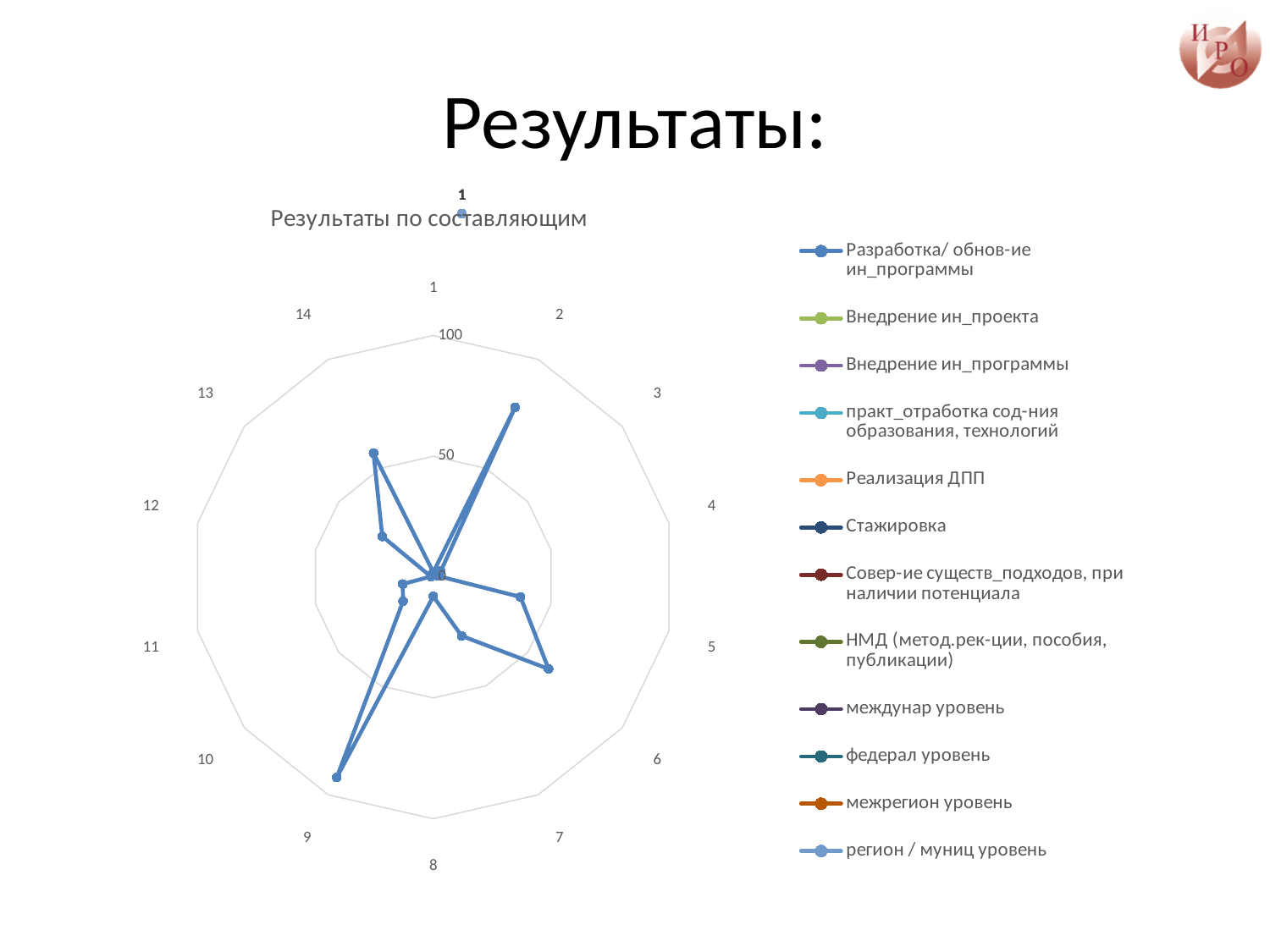
Is the value for category 8 greater or less than 50? less Is the value for category 9 greater or less than 50? greater How many series does the legend list? 12 Which has the larger plotted value, category 2 or category 12? category 2 Is the value for category 12 greater or less than 50? less What kind of chart is shown on the slide? radar chart Which category has the highest plotted value? 9 What is the highest value shown on the chart's radial axis? 100 What is the title of the chart? Результаты по составляющим How many categories (axes) does the radar chart have? 14